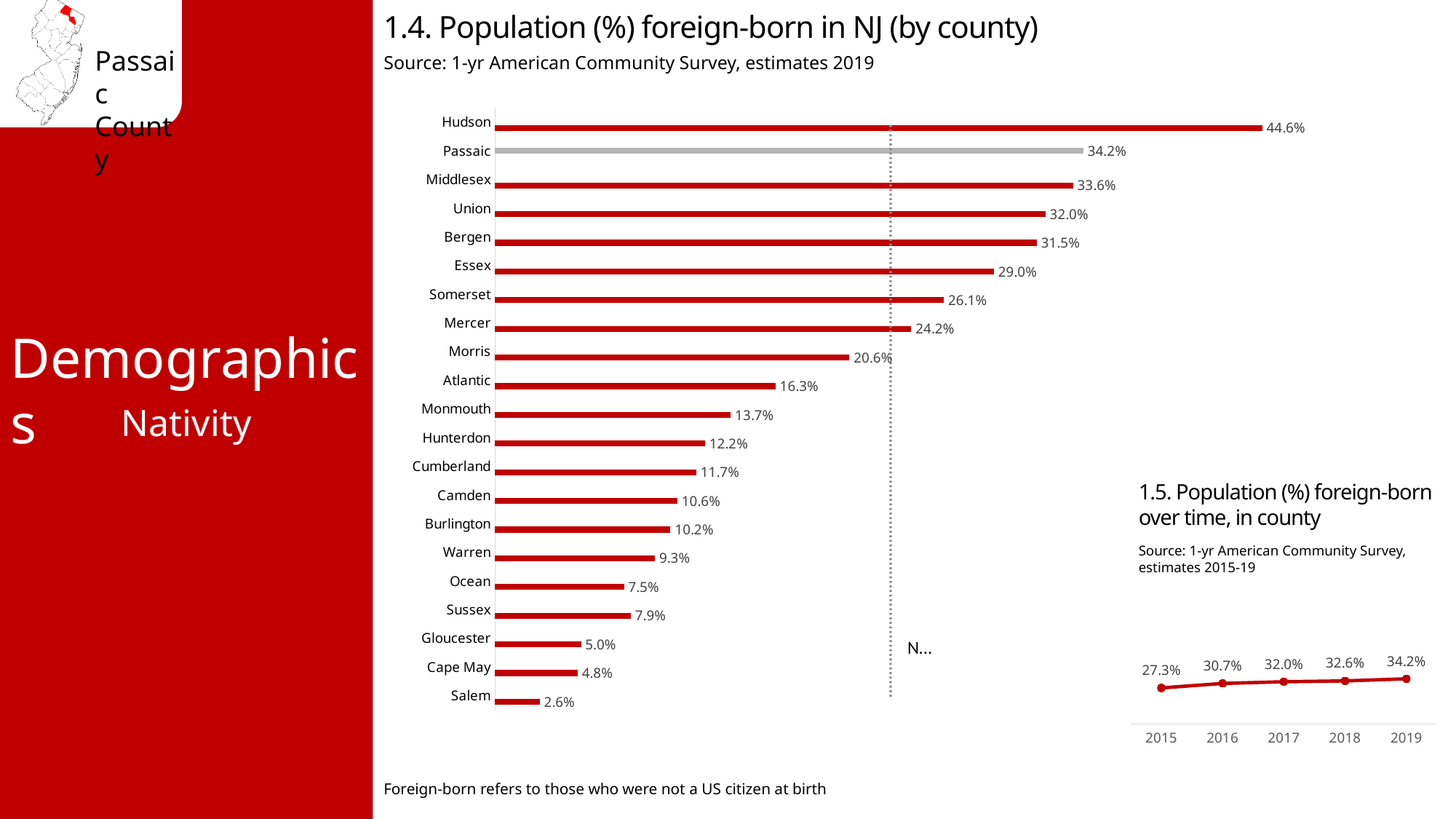
What kind of chart is '1.4. Population (%) foreign-born in NJ (by county)'? Bar chart In the chart '1.4. Population (%) foreign-born in NJ (by county)', which county has the lowest value? Salem In the chart '1.5. Population (%) foreign-born over time, in county', what is the value for 2015? 27.3% In the chart '1.4. Population (%) foreign-born in NJ (by county)', what is the difference between Hudson and Passaic? 10.4% How many counties are shown in the chart '1.4. Population (%) foreign-born in NJ (by county)'? 21 In the chart '1.4. Population (%) foreign-born in NJ (by county)', what is the value for Passaic? 34.2% In the chart '1.5. Population (%) foreign-born over time, in county', what is the difference between the 2019 and 2015 values? 6.9% In the chart '1.4. Population (%) foreign-born in NJ (by county)', what is the value for Mercer? 24.2% How many years are plotted in the chart '1.5. Population (%) foreign-born over time, in county'? 5 In the chart '1.5. Population (%) foreign-born over time, in county', do the values rise or fall from 2015 to 2019? Rise In the chart '1.4. Population (%) foreign-born in NJ (by county)', which county has the highest value? Hudson In the chart '1.4. Population (%) foreign-born in NJ (by county)', which is larger, the value for Ocean or the value for Sussex? Sussex